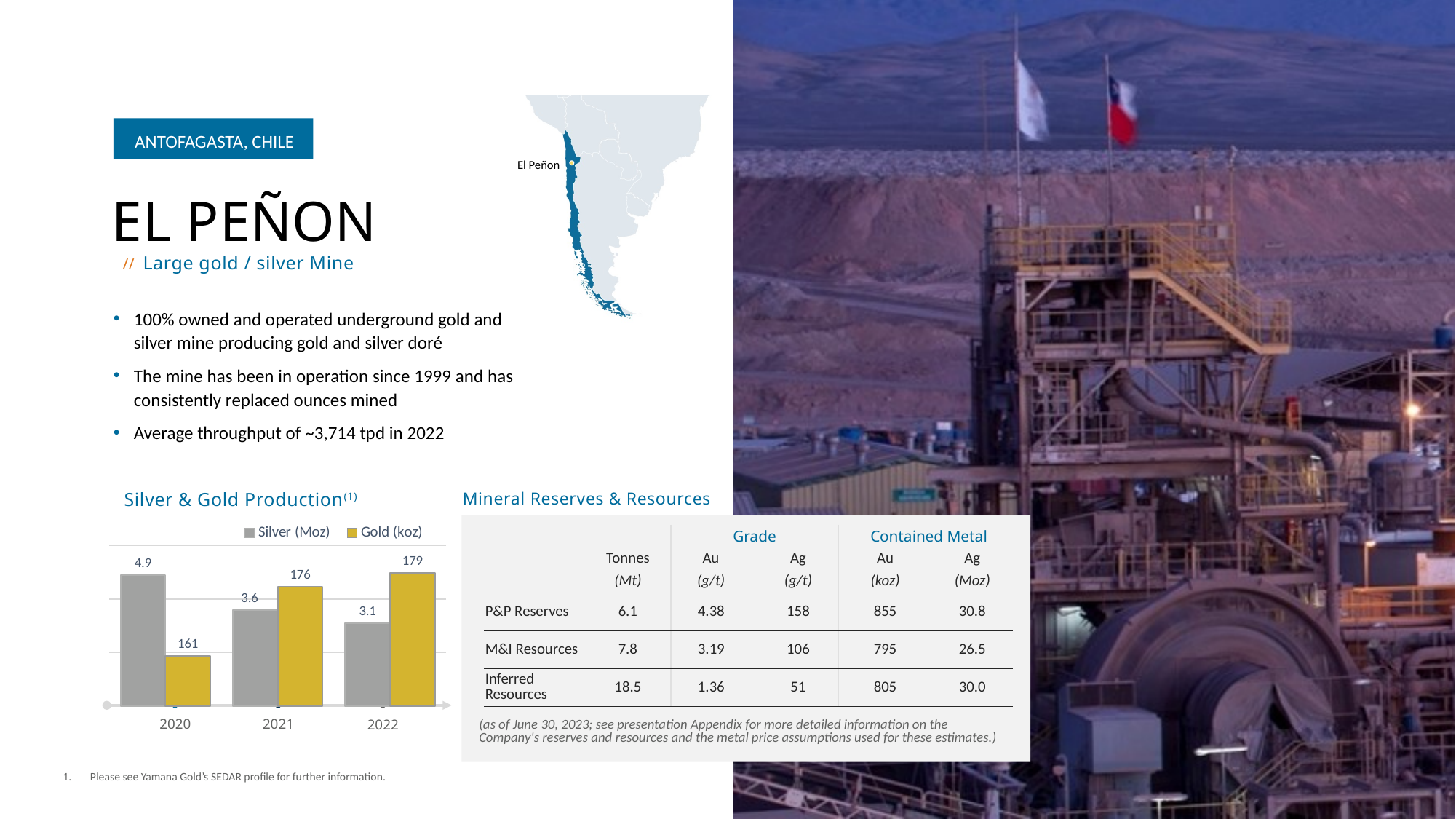
How many series does the legend of the Silver & Gold Production chart list? 2 What was the gold production in 2022? 179 What kind of chart is the Silver & Gold Production chart? Bar chart Which year had higher silver production, 2020 or 2022? 2020 What was the silver production in 2021? 3.6 What was the gold production in 2020? 161 How many years are shown on the x axis of the Silver & Gold Production chart? 3 What was the silver production in 2020? 4.9 Does silver production rise or fall from 2020 to 2022? Fall Which year had the lowest silver production? 2022 Which year had the highest gold production? 2022 What is the difference between gold production in 2022 and 2020? 18